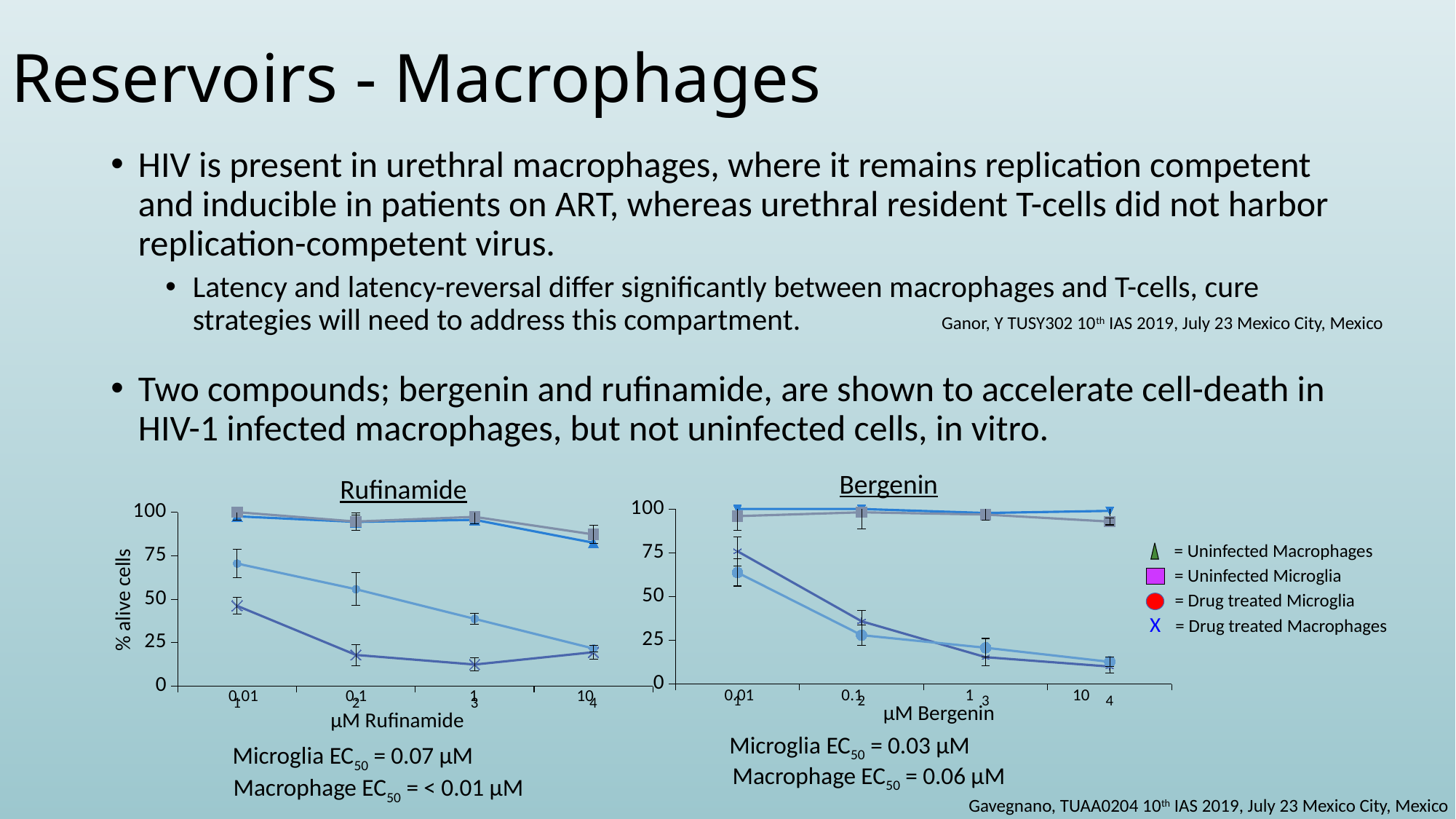
In the Bergenin chart, is the value for Drug treated Microglia at 0.01 µM greater or less than 75? less In the Bergenin chart, is the value for Uninfected Macrophages at 0.01 µM greater or less than 75? greater What is the x-axis label of the Bergenin chart? µM Bergenin In the Rufinamide chart at 0.01 µM, which is larger: Drug treated Microglia or Drug treated Macrophages? Drug treated Microglia What kind of chart is the Rufinamide chart? line chart How many series does the legend list for the charts? 4 What is the y-axis label of the Rufinamide chart? % alive cells In the Rufinamide chart, is the value for Drug treated Microglia at 0.01 µM greater or less than 50? greater In the Bergenin chart, does the Drug treated Microglia series rise or fall as the concentration increases? fall How many concentration points are plotted along the x axis of the Bergenin chart? 4